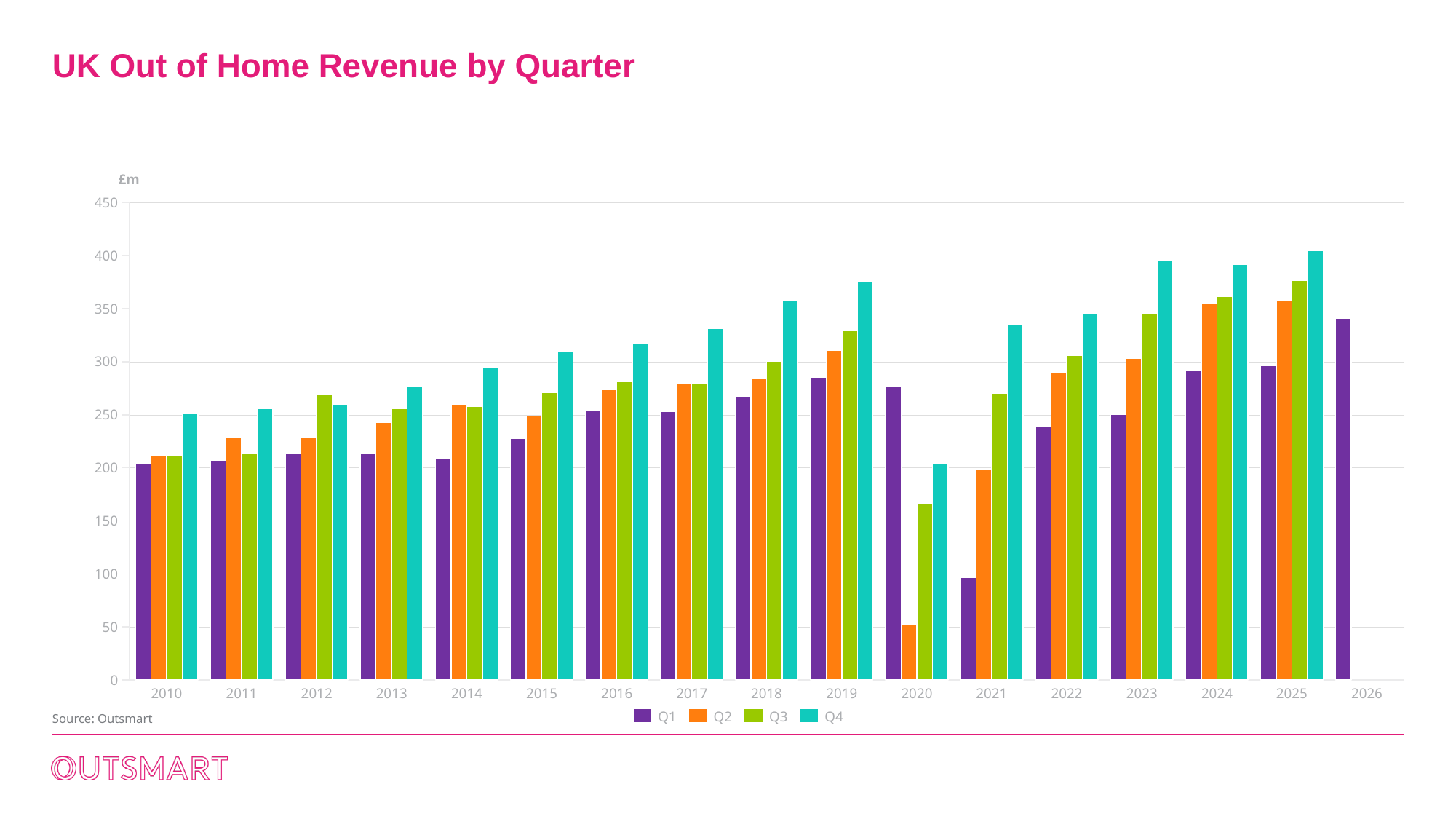
How many series does the legend list? 4 Is the value for Q4 2019 greater or less than 350? greater Is the value for Q1 2026 greater or less than 300? greater Which quarter has the highest bar in 2010? Q4 Is the value for Q2 2020 greater or less than 100? less Which year and quarter has the lowest bar on the chart? Q2 2020 How many years are shown along the x axis? 17 Do the Q4 values rise or fall from 2010 to 2019? rise Which is larger, the Q1 value for 2020 or the Q1 value for 2021? 2020 Which year and quarter has the highest bar on the chart? Q4 2025 What kind of chart is shown on the slide? bar chart What unit is shown on the y axis? £m